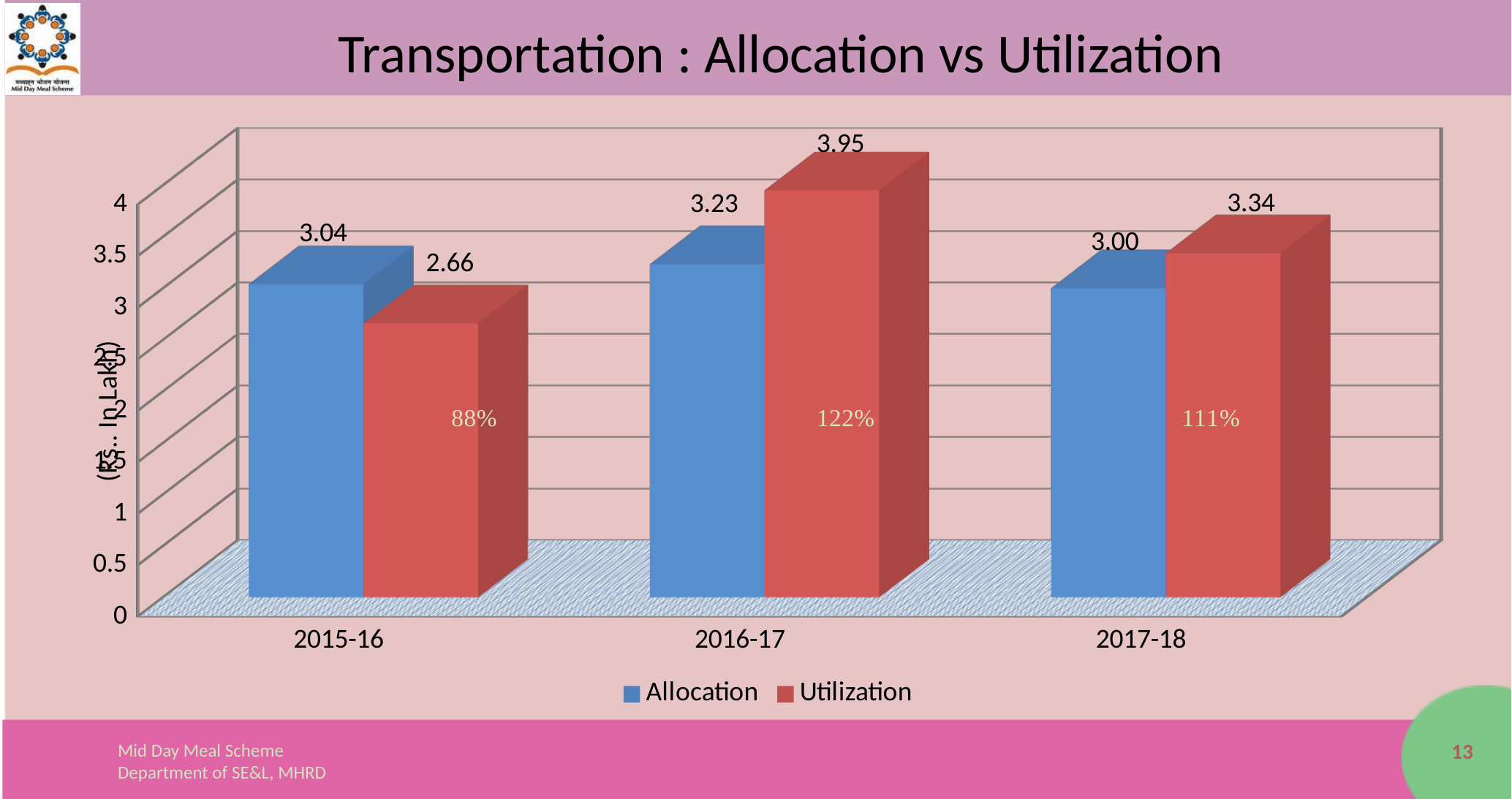
What is the Utilization value for 2017-18? 3.34 Which year has the highest Utilization value? 2016-17 In 2015-16, which is larger, Allocation or Utilization? Allocation Which year has the lowest Utilization value? 2015-16 How many series does the legend list? 2 What is the Allocation value for 2015-16? 3.04 What is the Utilization value for 2016-17? 3.95 What kind of chart is shown on the slide? Bar chart What is the Allocation value for 2017-18? 3.00 How many years are shown on the x axis? 3 What percentage label is shown on the Utilization bar for 2017-18? 111% What is the difference between Utilization and Allocation in 2016-17? 0.72